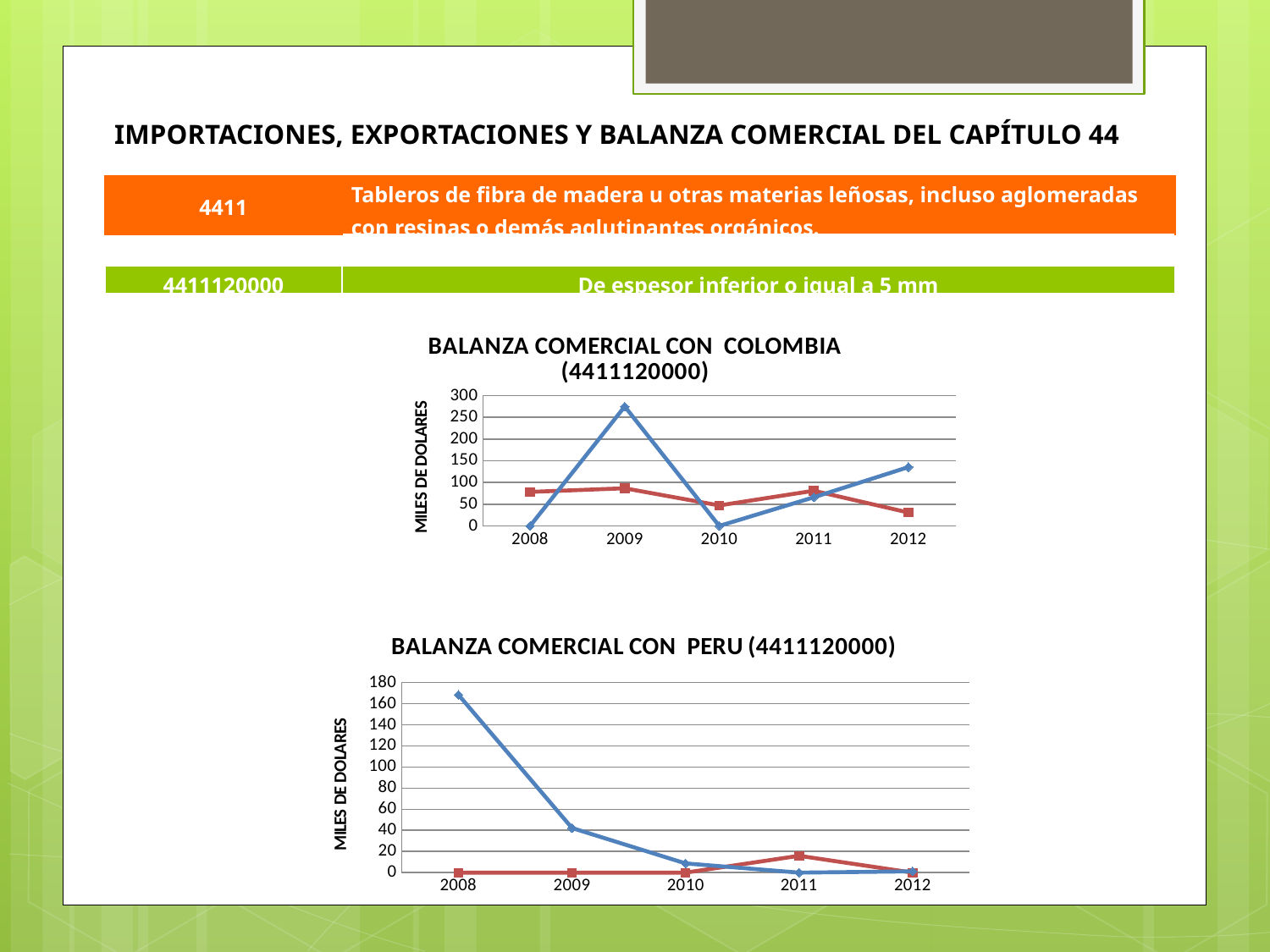
What kind of chart is the 'BALANZA COMERCIAL CON COLOMBIA (4411120000)' chart? line chart In the 'BALANZA COMERCIAL CON COLOMBIA' chart, is the value of the red line in 2012 greater or less than 50? less What kind of chart is the 'BALANZA COMERCIAL CON PERU (4411120000)' chart? line chart In the 'BALANZA COMERCIAL CON COLOMBIA' chart, which line has the larger value in 2012, the blue line or the red line? the blue line In the 'BALANZA COMERCIAL CON COLOMBIA' chart, is the value of the blue line in 2009 greater or less than 250? greater In the 'BALANZA COMERCIAL CON PERU' chart, in which year does the blue line reach its highest value? 2008 In the 'BALANZA COMERCIAL CON PERU' chart, is the value of the blue line in 2008 greater or less than 160? greater In the 'BALANZA COMERCIAL CON PERU' chart, does the blue line rise or fall from 2008 to 2010? fall In the 'BALANZA COMERCIAL CON PERU' chart, in which year does the red line reach its highest value? 2011 What is the y-axis label of the 'BALANZA COMERCIAL CON PERU' chart? MILES DE DOLARES In the 'BALANZA COMERCIAL CON COLOMBIA' chart, how many years are shown on the x axis? 5 In the 'BALANZA COMERCIAL CON COLOMBIA' chart, in which year does the blue line reach its highest value? 2009